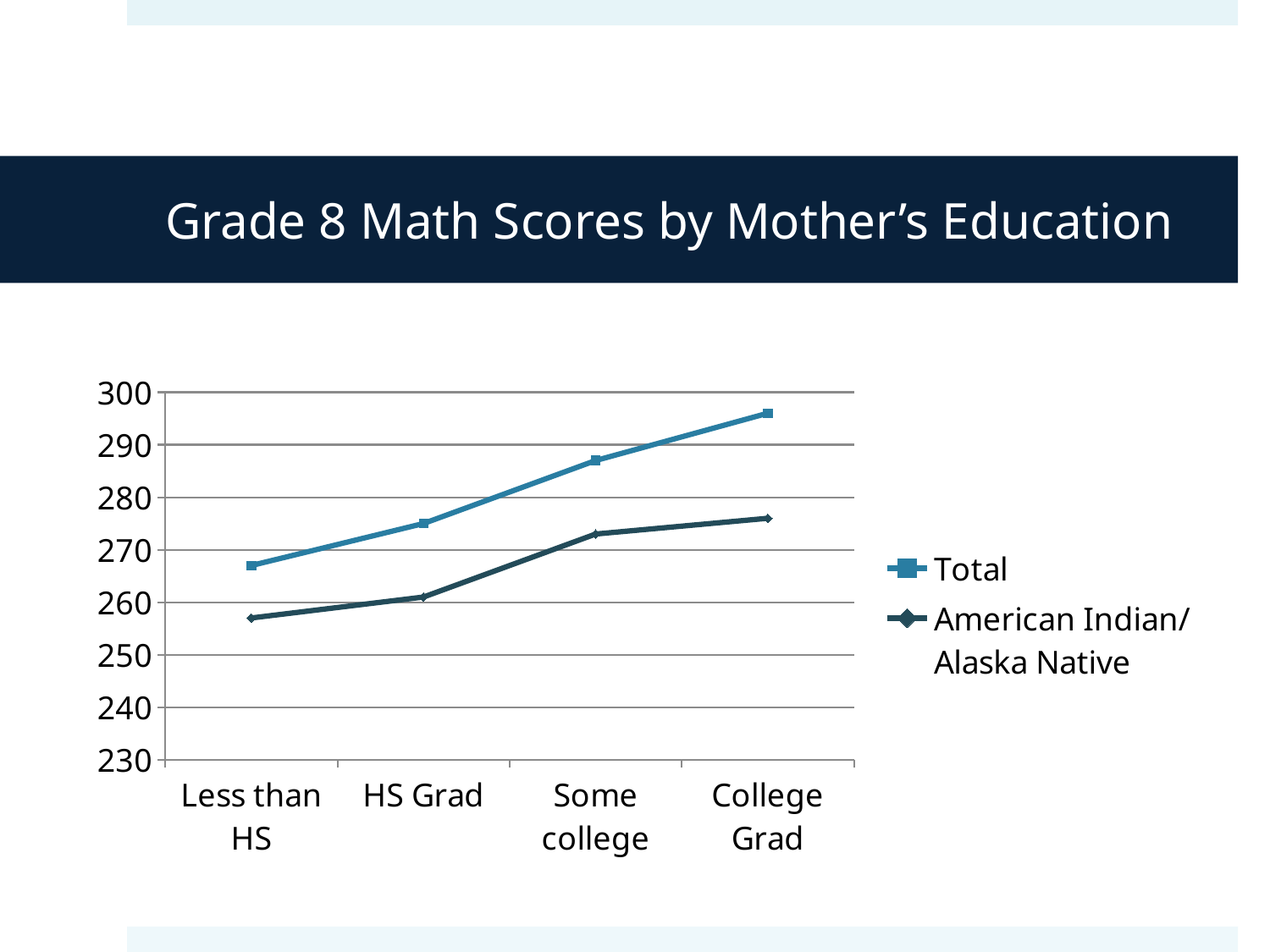
How many series does the legend list? 2 Which mother's education category has the lowest American Indian/Alaska Native score? Less than HS What kind of chart is shown on the slide? line chart Is the American Indian/Alaska Native score for Less than HS greater or less than 260? less Is the Total score for HS Grad greater or less than 280? less At College Grad, which series has the higher score, Total or American Indian/Alaska Native? Total Is the Total score for College Grad greater or less than 290? greater How many mother's education categories are shown on the x axis? 4 Which mother's education category has the highest Total score? College Grad Do the Total scores rise or fall as mother's education increases from Less than HS to College Grad? rise